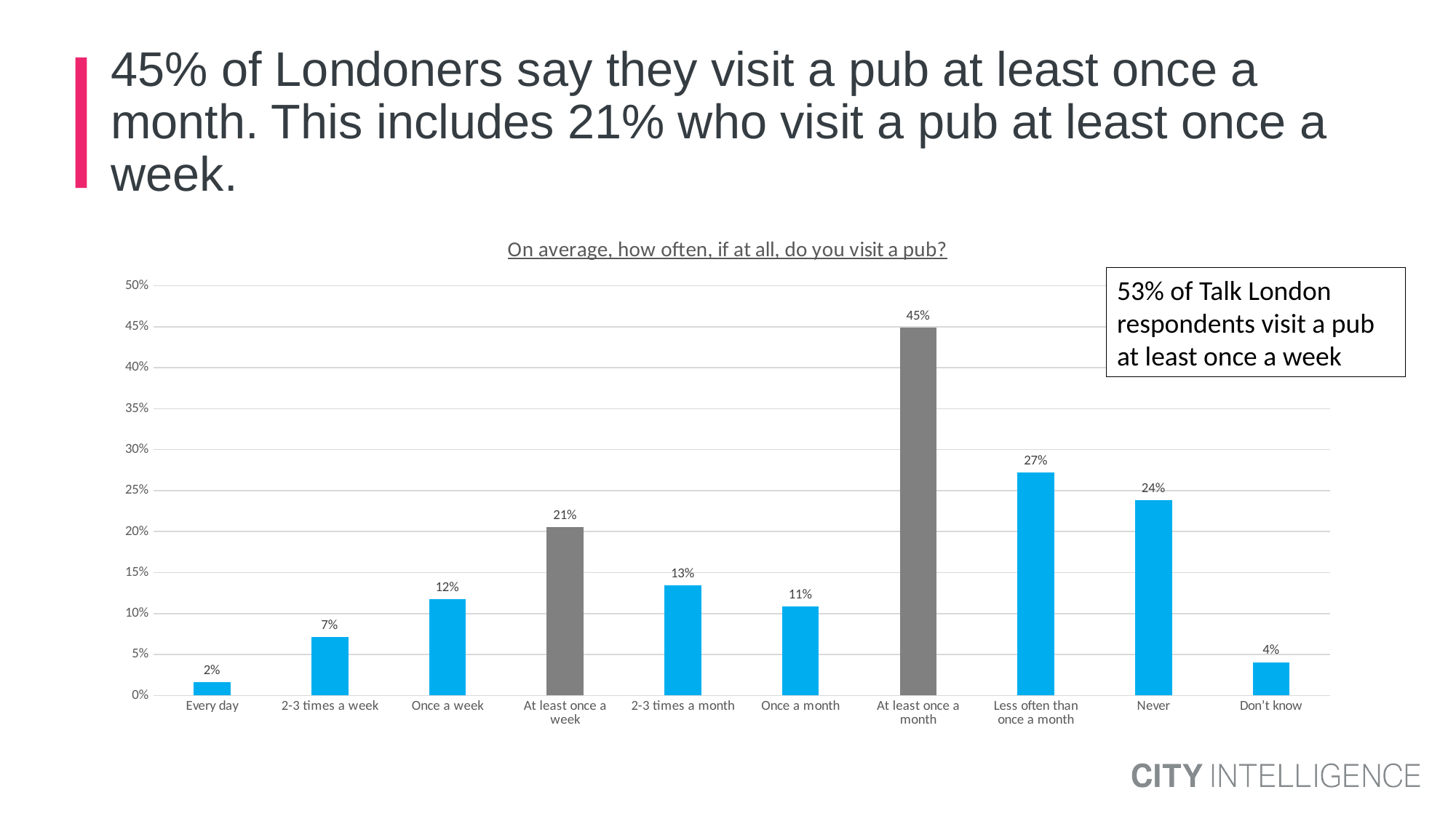
What is the difference between the values for 'At least once a month' and 'At least once a week'? 24% Which is larger, the value for 'Once a week' or the value for 'Once a month'? Once a week Is the value for 'Less often than once a month' greater or less than 25%? greater How many categories are shown on the x axis of the chart? 10 What percentage of respondents say they visit a pub every day? 2% What kind of chart is shown on the slide? Bar chart Which category has the lowest value in the chart? Every day What is the title of the chart? On average, how often, if at all, do you visit a pub? What is the value shown for '2-3 times a month'? 13% Which category has the highest value in the chart? At least once a month What is the value shown for 'Never'? 24% What is the value shown for 'Less often than once a month'? 27%